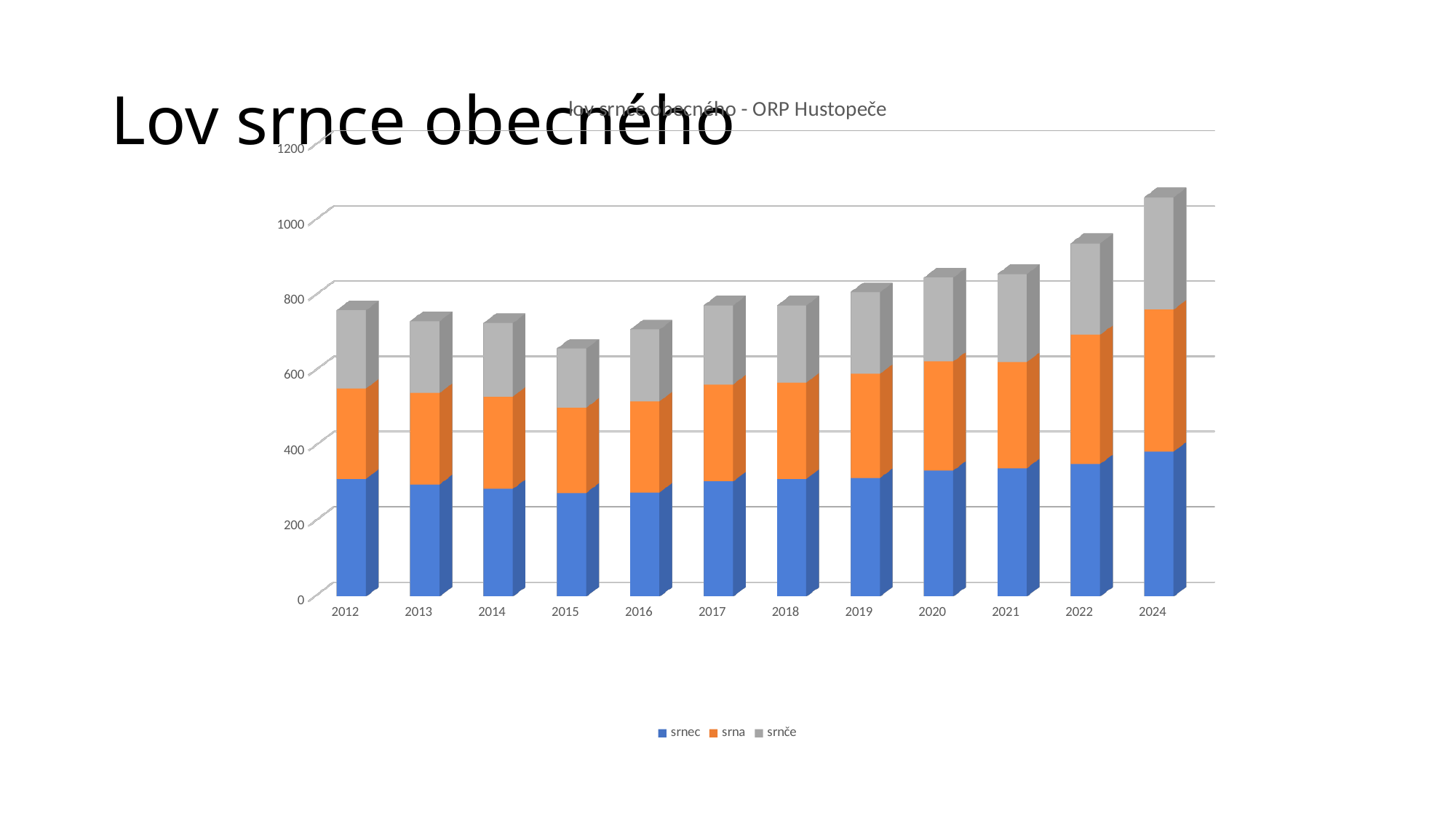
How many series does the chart legend list? 3 Is the total value for 2015 greater or less than 800? less Which series is shown in orange in the chart? srna How many years are shown on the x axis of the chart? 12 Is the total value for 2022 greater or less than 1000? less Is the total value for 2024 greater or less than 1000? greater Which year has the highest total stacked bar? 2024 What are the three series listed in the chart legend? srnec, srna, srnče Do the total stacked bar values rise or fall from 2016 to 2024? rise Which year has the lowest total stacked bar? 2015 What kind of chart is shown on the slide? stacked bar chart Which year has the larger total stacked bar, 2015 or 2020? 2020